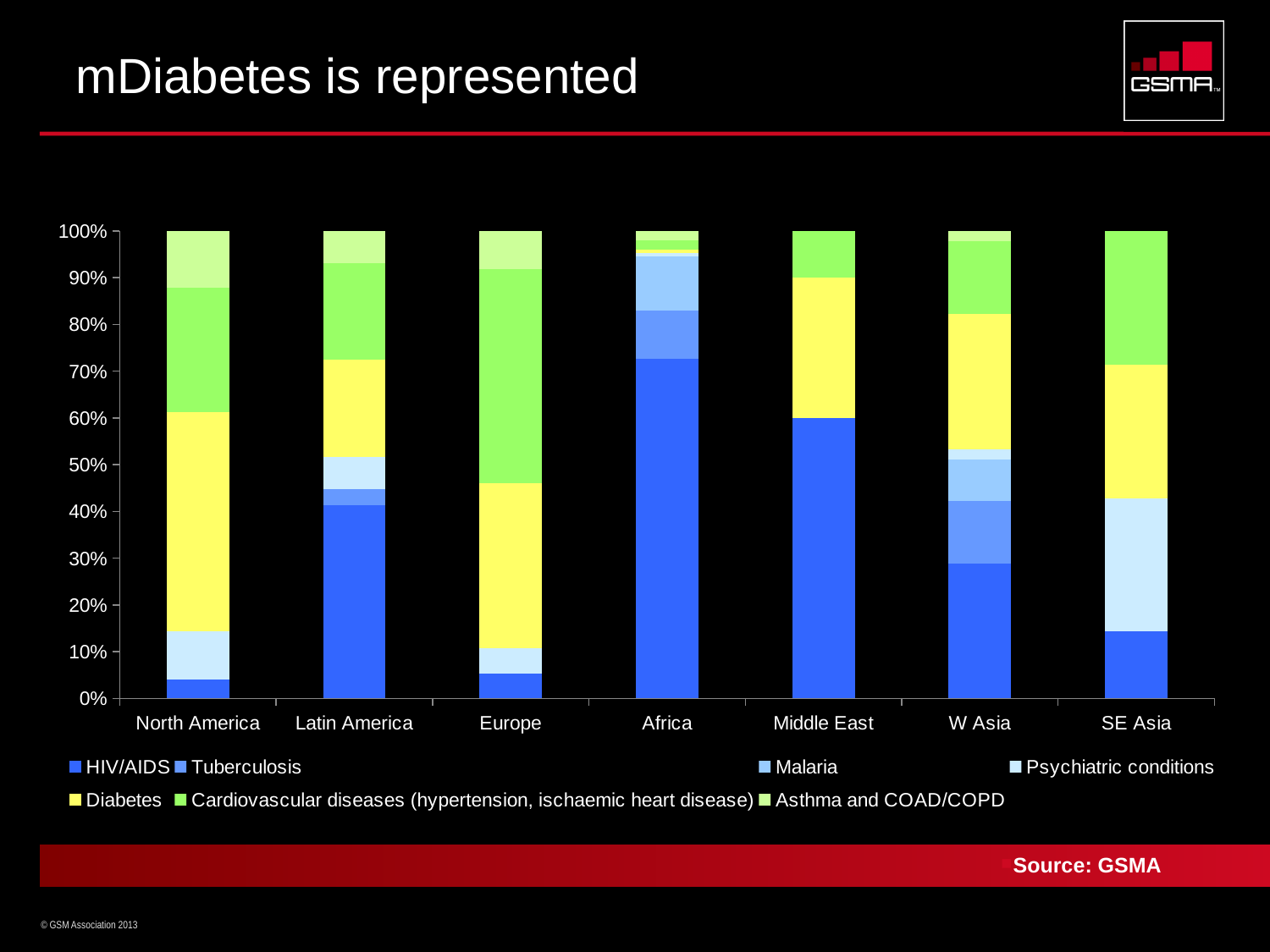
Which has the larger HIV/AIDS share, Africa or Middle East? Africa What does each stacked bar in the chart total? 100% What kind of chart is shown on the slide? Stacked bar chart Is the HIV/AIDS share for Latin America greater or less than 30%? greater Is the HIV/AIDS share for Africa greater or less than 60%? greater Which region has the largest HIV/AIDS share in the chart? Africa Which region has the largest Diabetes share in the chart? North America Which has the larger Diabetes share, North America or Latin America? North America How many series does the chart's legend list? 7 How many regions are shown along the x axis of the chart? 7 What is the title of the slide containing the chart? mDiabetes is represented Is the HIV/AIDS share for SE Asia greater or less than 20%? less